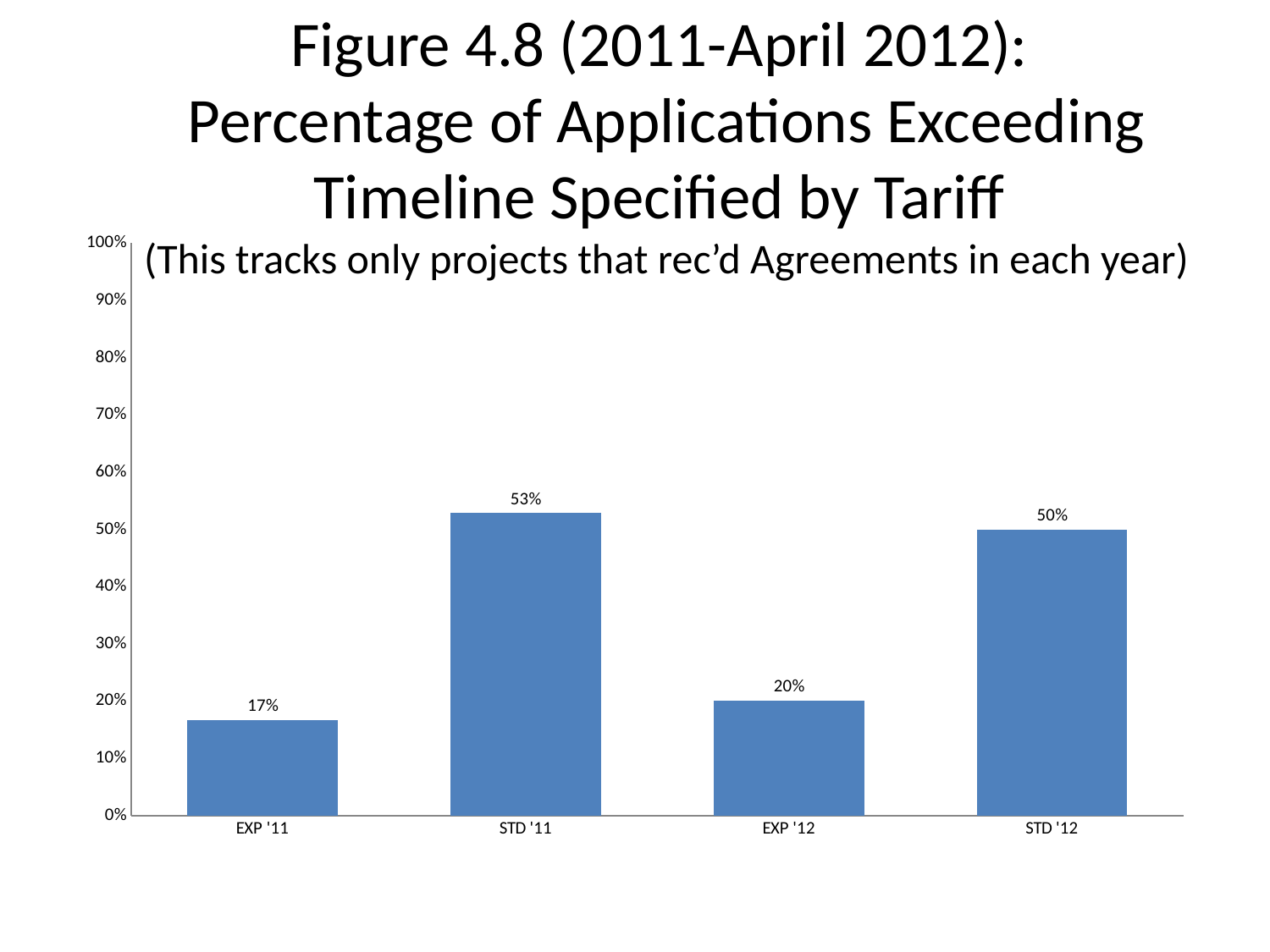
Which category has the lowest value? EXP '11 Which is larger, the value for EXP '12 or the value for EXP '11? EXP '12 What is the value for STD '12? 50% Is the value for STD '12 greater or less than 40%? greater What is the value for EXP '11? 17% What is the difference between the values for STD '11 and EXP '11? 36% What is the value for EXP '12? 20% What kind of chart is shown on the slide? bar chart What is the value for STD '11? 53% How many categories are shown on the x axis? 4 Which category has the highest value? STD '11 What is the difference between the values for STD '12 and EXP '12? 30%